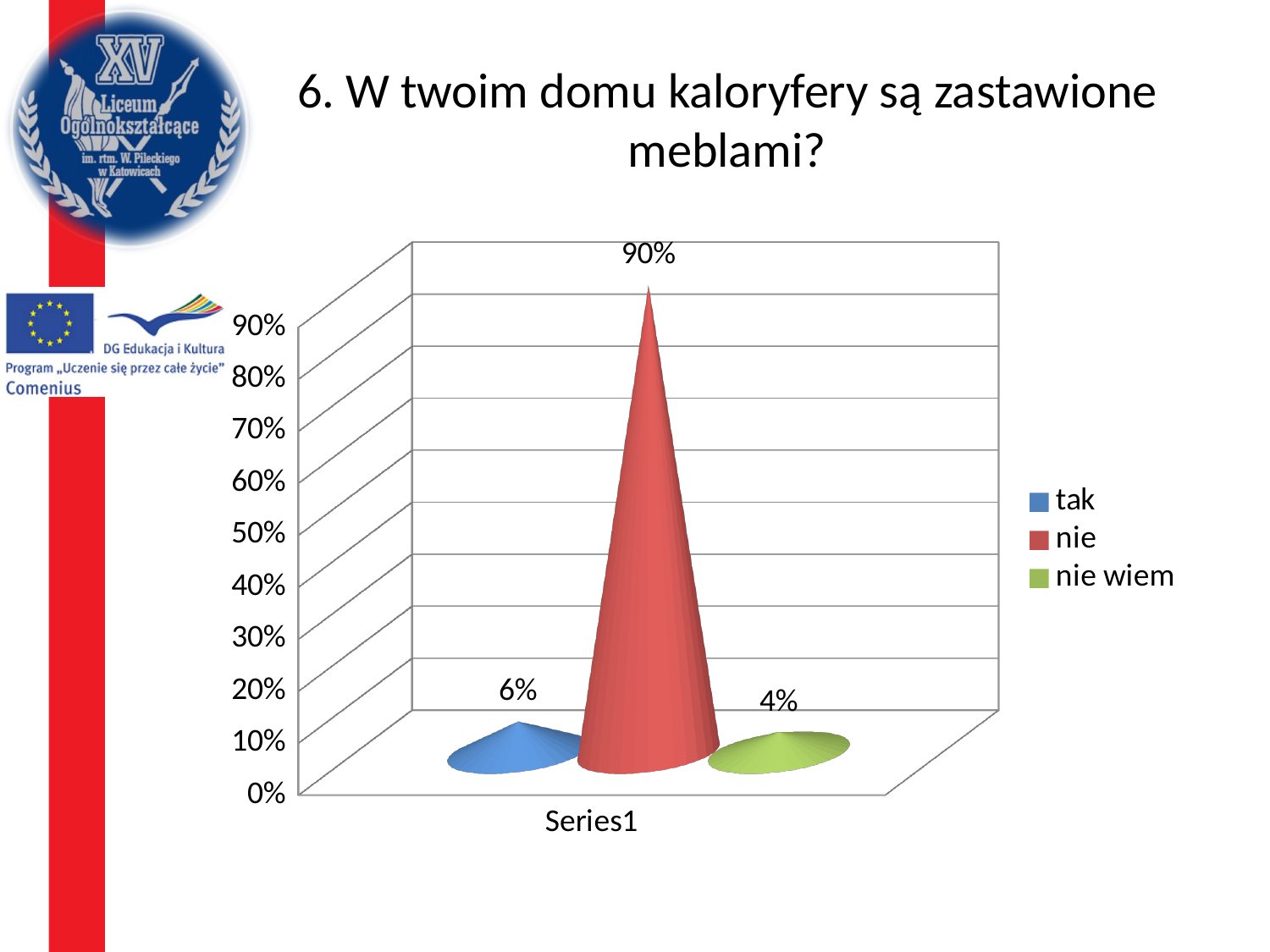
What colour represents "nie" in the legend? red Is the value for "nie" greater or less than 50%? greater What is the value for "tak"? 6% What is the difference between the values for "nie" and "tak"? 84% What is the difference between the values for "tak" and "nie wiem"? 2% Which answer has the highest value? nie What is the value for "nie wiem"? 4% What is the value for "nie"? 90% Which answer has the lowest value? nie wiem What kind of chart is shown on the slide? bar chart Which is larger, the value for "tak" or the value for "nie wiem"? tak How many series does the legend list? 3